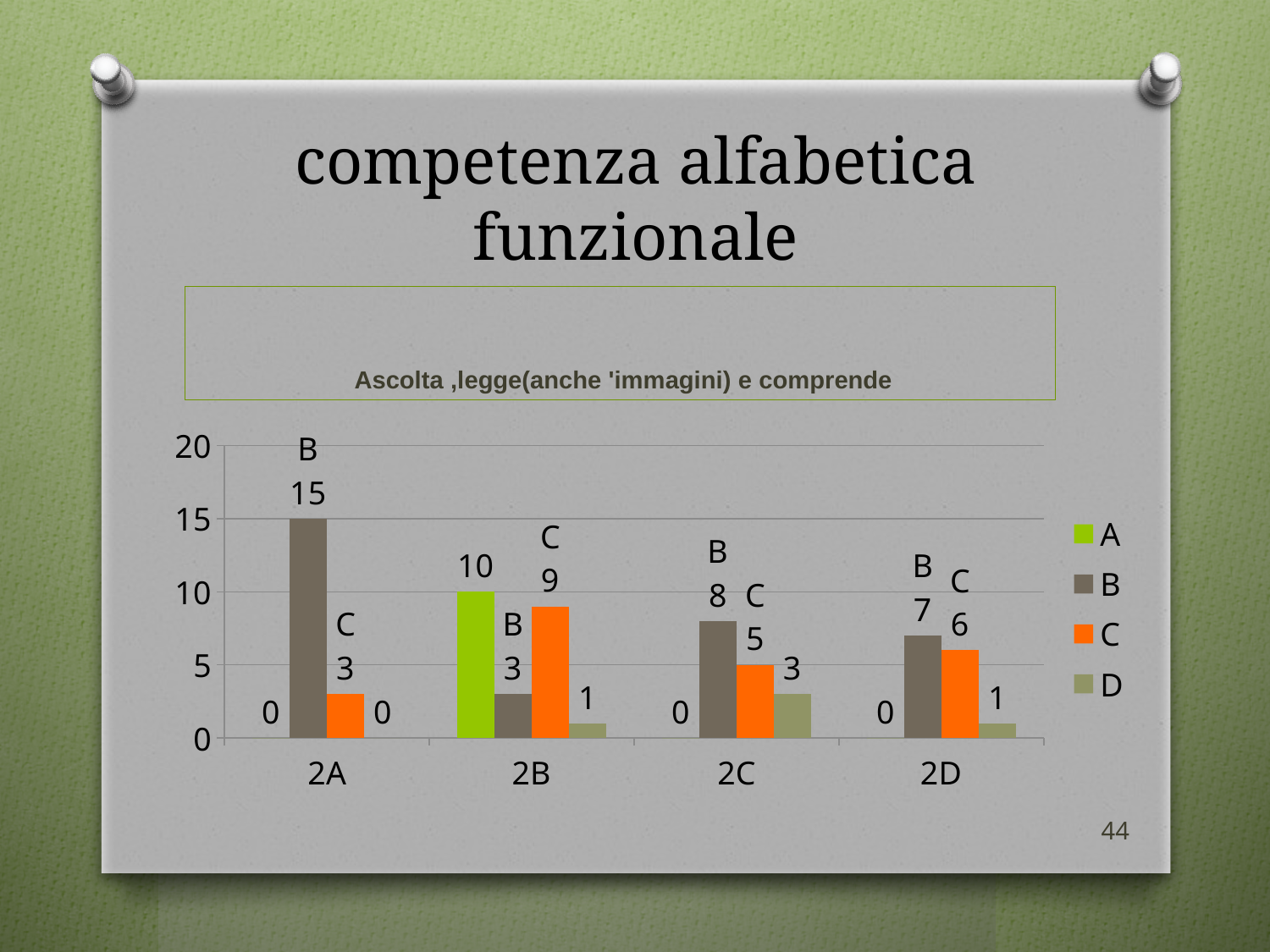
What is the value of series C for category 2B? 9 What is the value of series D for category 2C? 3 Which category has the highest value for series B? 2A What is the value of series B for category 2A? 15 What is the value of series A for category 2B? 10 Which is larger for category 2C: the value of series B or series C? B What kind of chart is shown on the slide? bar chart What is the difference between the B value and the C value for category 2D? 1 Which category has the lowest value for series C? 2A How many categories are shown on the x axis? 4 What is the title of the chart? Ascolta ,legge(anche 'immagini) e comprende How many series does the legend list? 4